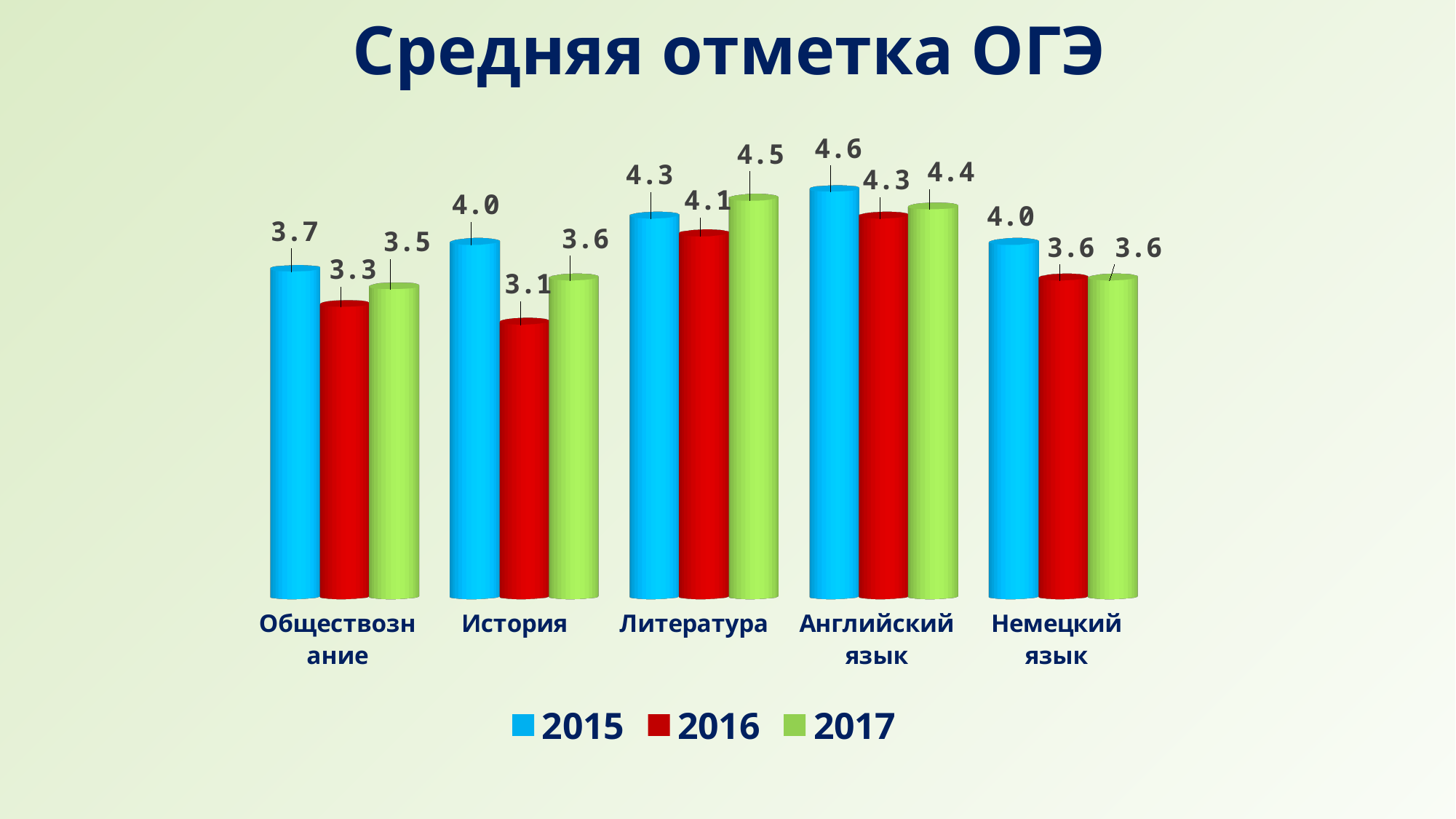
What is the value for Литература in 2017? 4.5 What is the difference between the 2015 and 2016 values for История? 0.9 What is the value for Немецкий язык in 2016? 3.6 How many series does the legend list? 3 What is the title of the chart? Средняя отметка ОГЭ Which category has the lowest value in 2016? История How many categories are shown on the x axis? 5 Which is larger: the 2017 value for Обществознание or the 2017 value for Немецкий язык? Немецкий язык Which category has the highest value in 2017? Литература What is the value for Английский язык in 2015? 4.6 What kind of chart is shown on the slide? Bar chart What is the value for История in 2016? 3.1